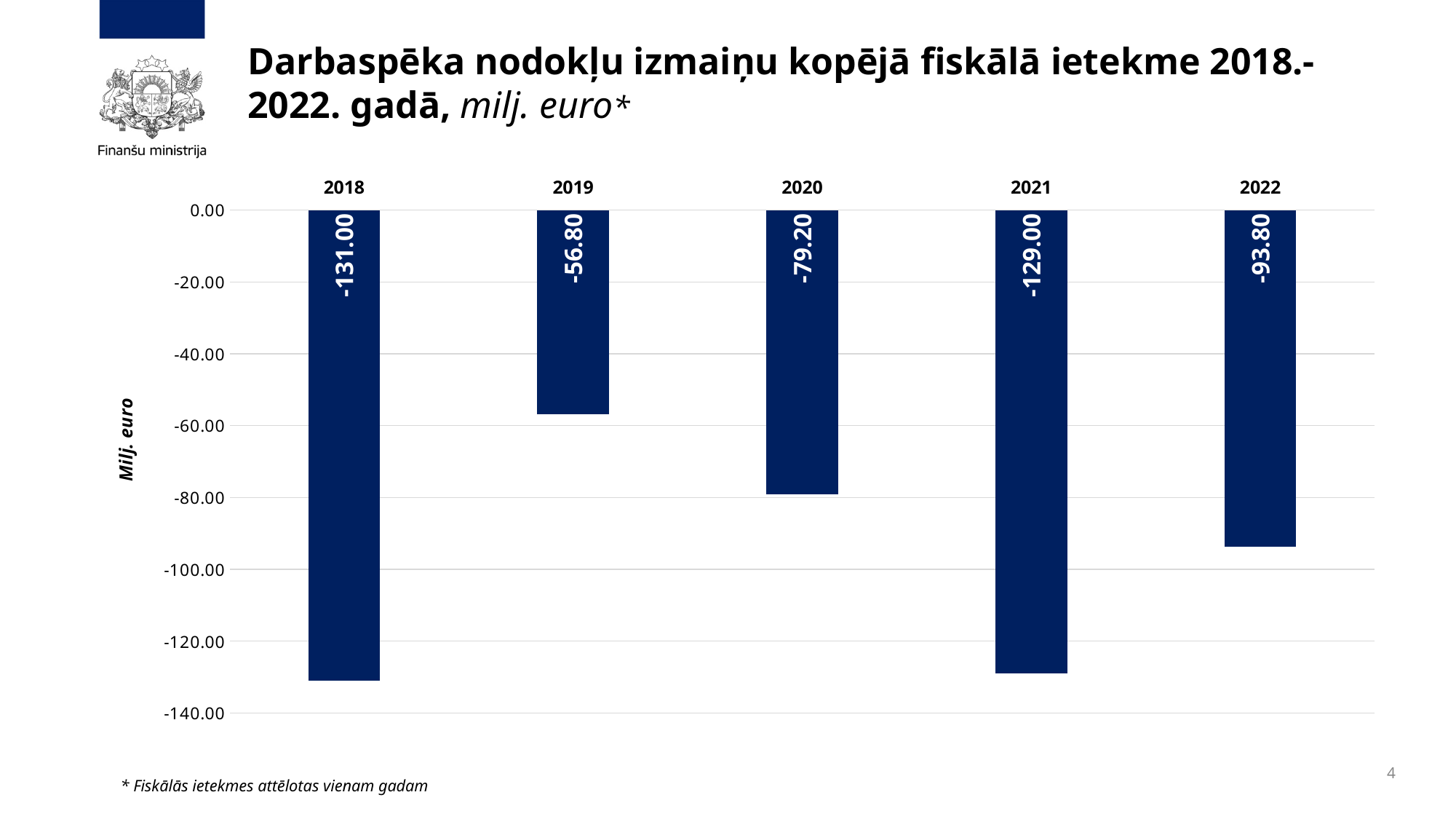
What is the value for 2021? -129.00 What kind of chart is shown on the slide? Bar chart What is the value for 2018? -131.00 What is the difference between the values for 2018 and 2021? 2.00 What is the value for 2019? -56.80 Which year has the lowest (most negative) value? 2018 Which year has the highest (least negative) value? 2019 What is the value for 2022? -93.80 How many years are shown on the chart? 5 What is the difference between the values for 2020 and 2019? 22.40 Which year has a more negative value, 2020 or 2022? 2022 What is the value for 2020? -79.20